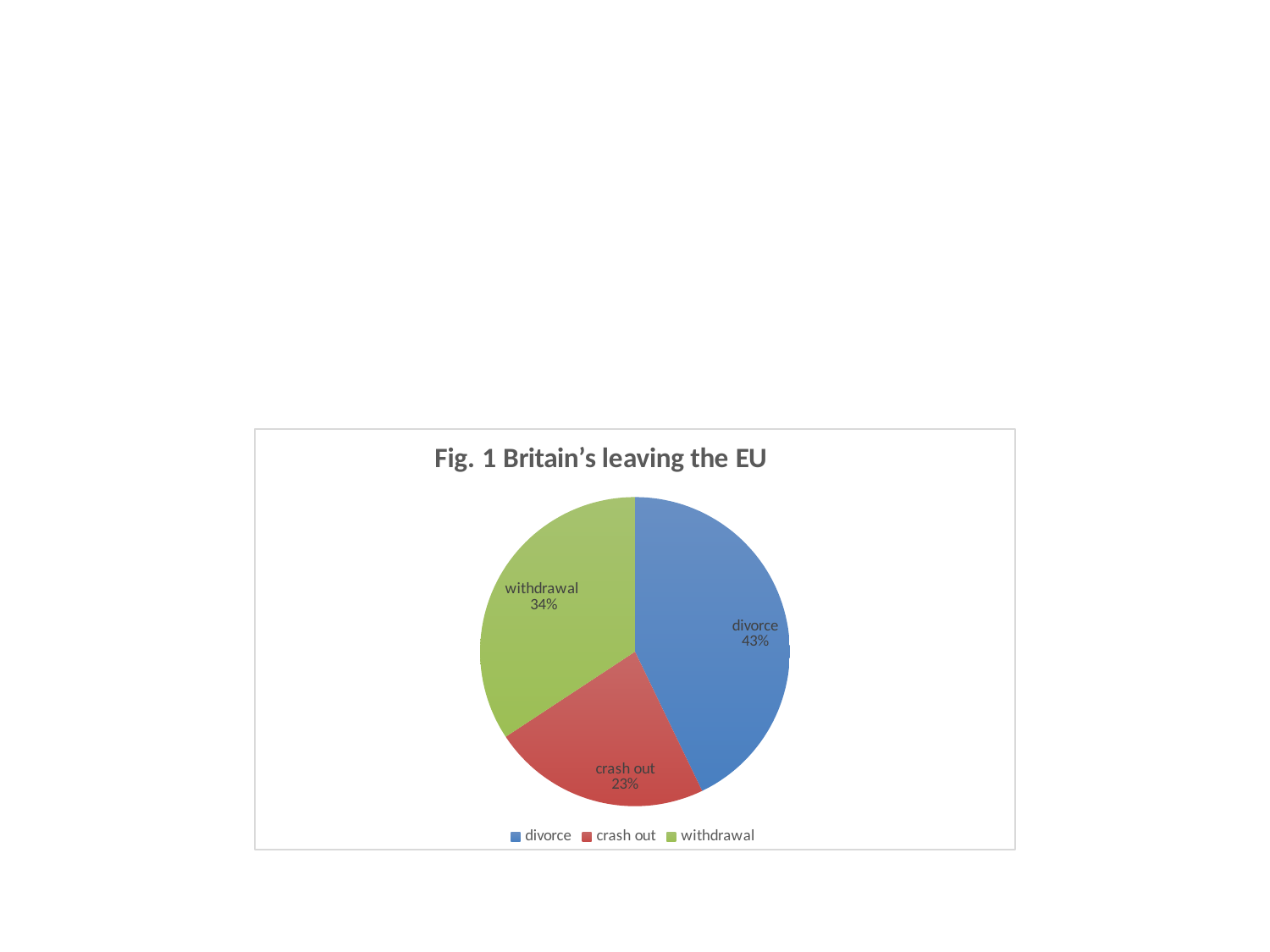
Which is larger, the 'withdrawal' slice or the 'crash out' slice? withdrawal How many categories are shown in the pie chart? 3 What share of the pie does the 'crash out' slice represent? 23% What is the title of the chart? Fig. 1 Britain's leaving the EU What kind of chart is shown on the slide? pie chart Which category has the largest slice of the pie? divorce What share of the pie does the 'withdrawal' slice represent? 34% What share of the pie does the 'divorce' slice represent? 43% What is the difference in percentage points between the 'withdrawal' and 'crash out' slices? 11 What is the difference in percentage points between the 'divorce' and 'crash out' slices? 20 What colour is the 'crash out' slice? red Which category has the smallest slice of the pie? crash out